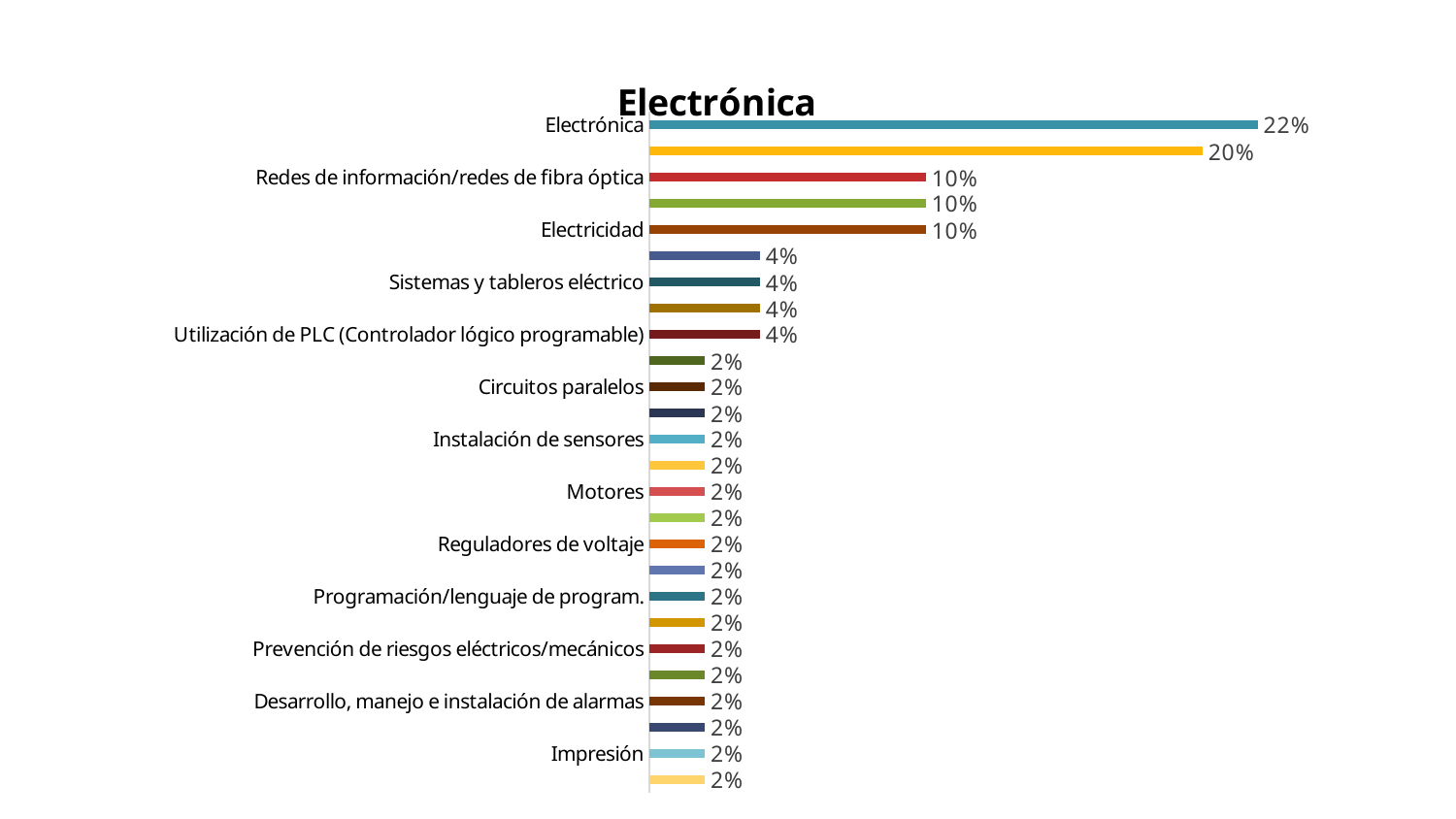
Which is larger, the value for Redes de información/redes de fibra óptica or the value for Sistemas y tableros eléctrico? Redes de información/redes de fibra óptica What is the value for Electrónica? 22% What is the value for Utilización de PLC (Controlador lógico programable)? 4% What is the value for Motores? 2% Which category has the highest value? Electrónica What is the title of the chart? Electrónica What is the value for Redes de información/redes de fibra óptica? 10% What is the difference between the values for Electrónica and Electricidad? 12% What is the value for Electricidad? 10% What kind of chart is shown on the slide? Bar chart What is the value for Sistemas y tableros eléctrico? 4% Do the values rise or fall going from the top bar to the bottom bar? Fall